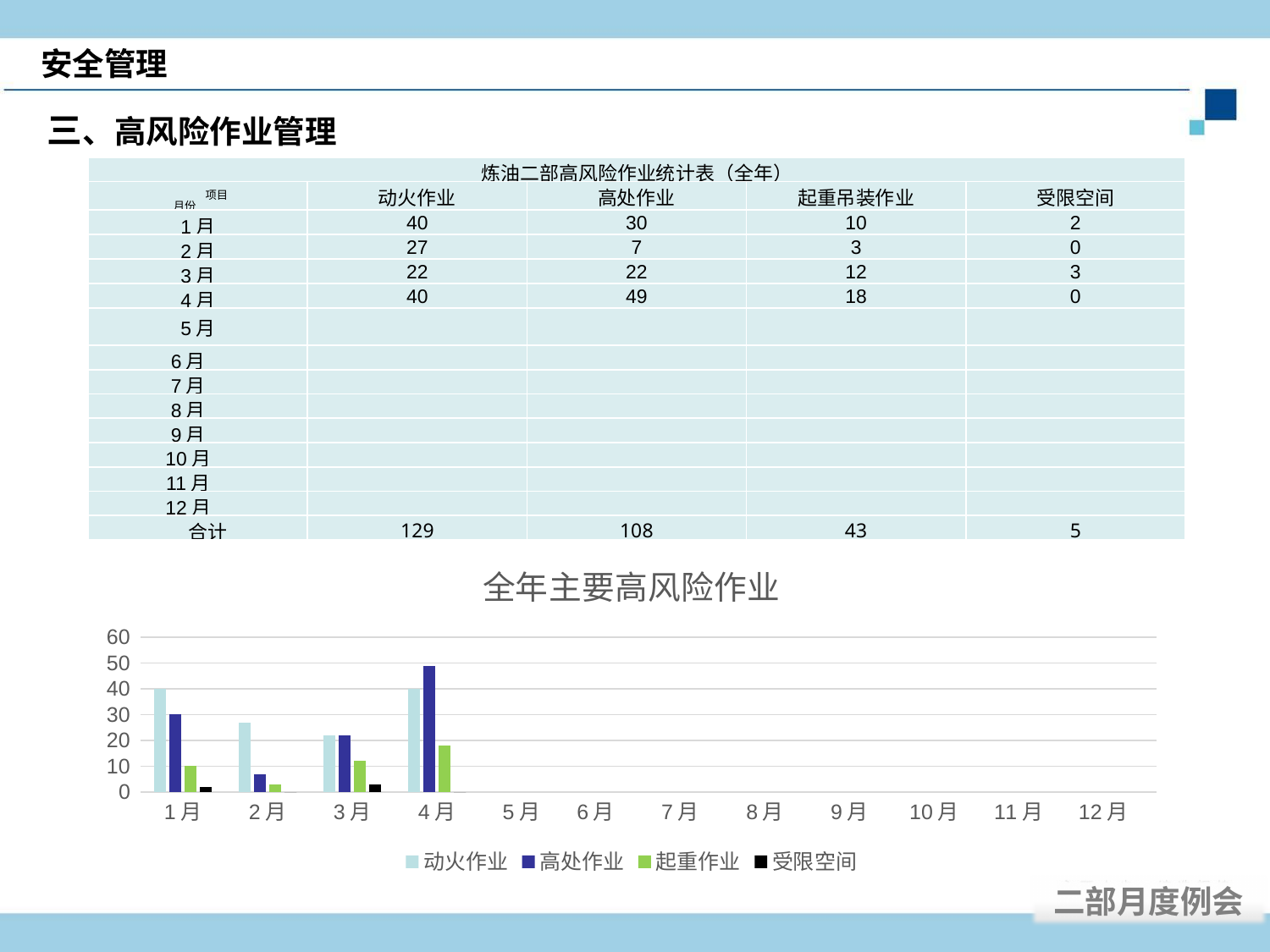
What is the value of 高处作业 for 1月 in the chart? 30 What is the title of the chart? 全年主要高风险作业 What kind of chart is shown on the slide? bar chart What is the difference between 动火作业 and 高处作业 in 1月? 10 Is the value for 高处作业 in 2月 greater or less than 10? less How many month categories are shown on the x axis of the chart? 12 How many series does the chart legend list? 4 Which month has the highest 高处作业 bar in the chart? 4月 Does the 高处作业 value rise or fall from 1月 to 2月? fall Is the value for 高处作业 in 4月 greater or less than 40? greater In 4月, which is larger in the chart, 动火作业 or 高处作业? 高处作业 What is the value of 动火作业 for 1月 in the chart? 40